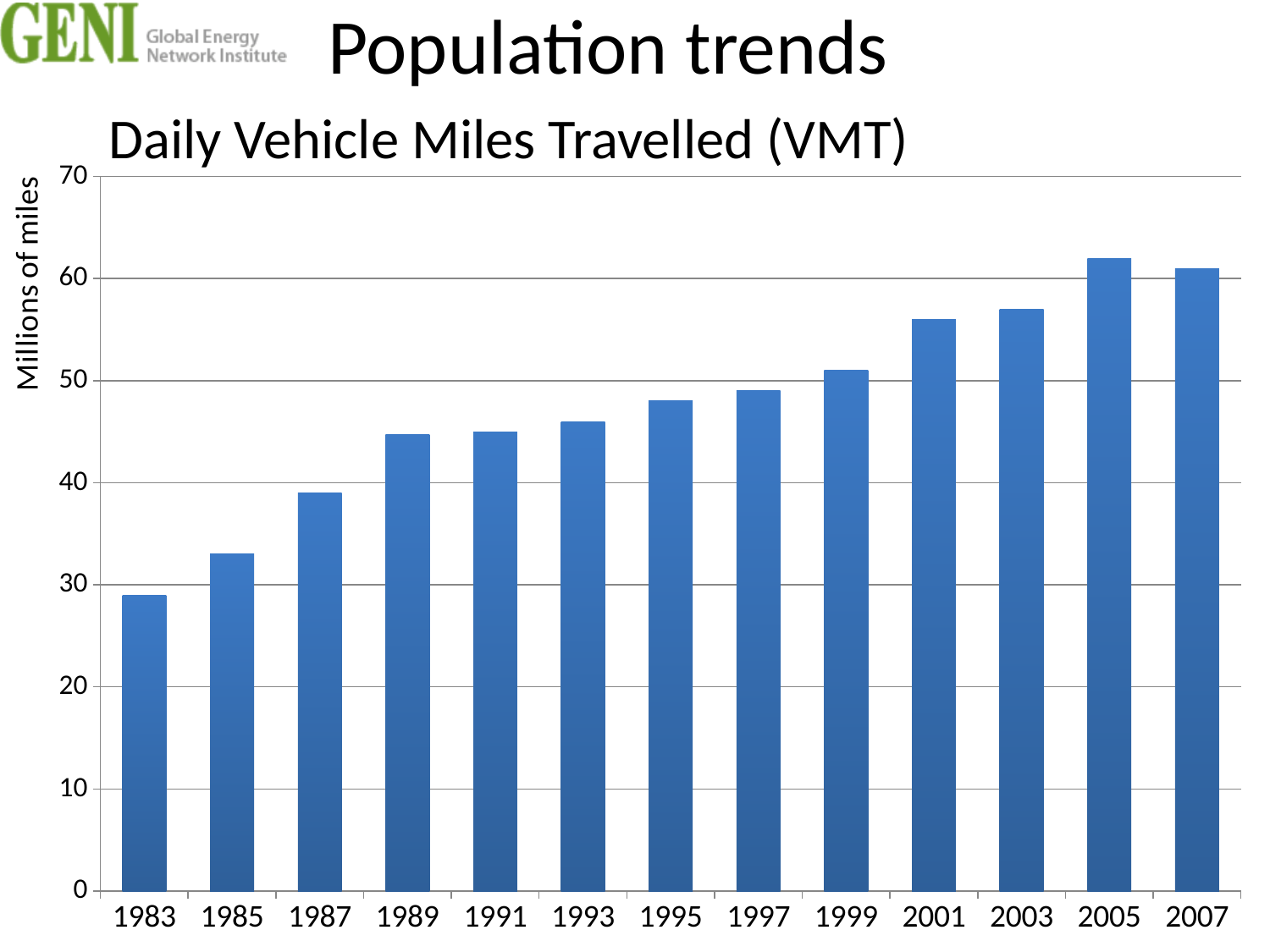
Do the values generally rise or fall from 1983 to 2007? rise Is the value for 1983 greater or less than 20? greater Which is larger, the value for 1999 or the value for 2001? 2001 Is the value for 1985 greater or less than 30? greater Is the value for 1995 greater or less than 50? less What kind of chart is shown on the slide? bar chart How many years are plotted on the x axis of the chart? 13 Which year has the lowest daily vehicle miles travelled? 1983 What is the label on the vertical axis of the chart? Millions of miles